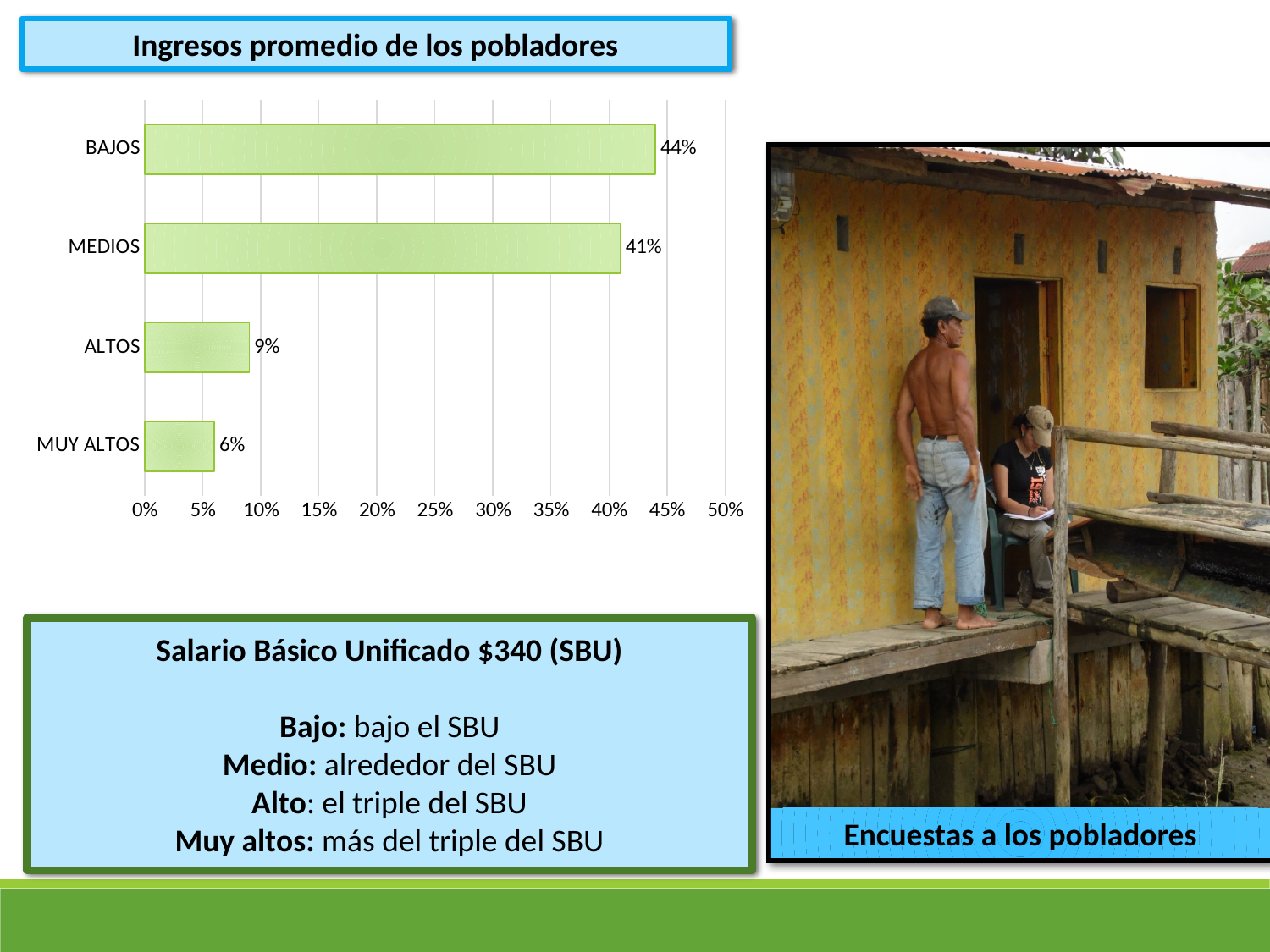
How many categories are shown in the chart? 4 What is the value for MUY ALTOS? 6% What kind of chart is shown on the slide? bar chart Which is larger, the value for ALTOS or the value for MUY ALTOS? ALTOS Which category has the highest value? BAJOS Is the value for MEDIOS greater or less than 40%? greater What is the difference between the values for ALTOS and MUY ALTOS? 3% What is the value for BAJOS? 44% What is the value for MEDIOS? 41% Which category has the lowest value? MUY ALTOS What is the value for ALTOS? 9% What is the difference between the values for BAJOS and MEDIOS? 3%